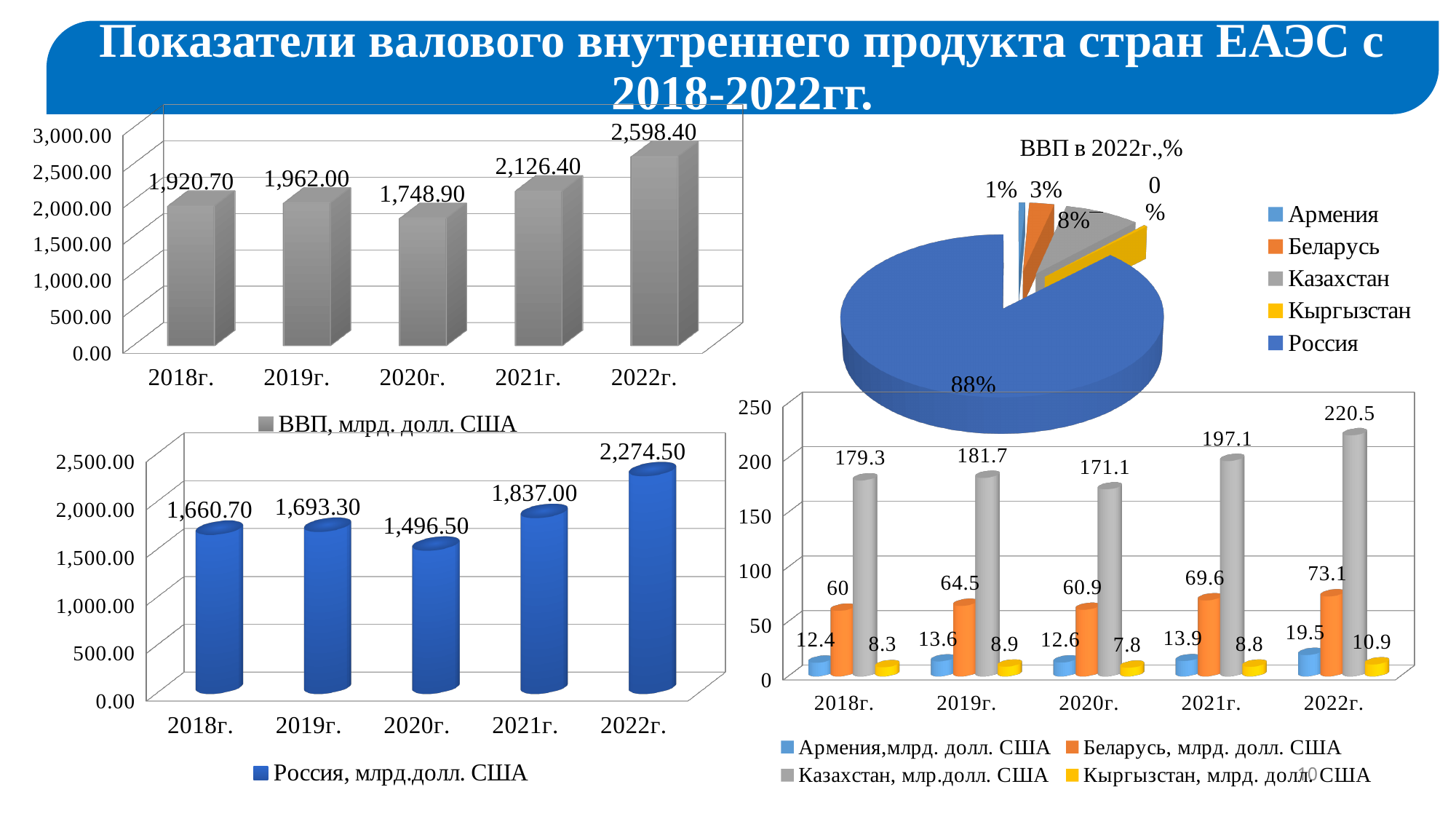
What type of chart is the top-right chart titled ВВП в 2022г.,%? Pie chart In the bottom-right chart, what is the value for Казахстан in 2021г.? 197.1 In the pie chart titled ВВП в 2022г.,%, how many entries does the legend list? 5 In the bottom-right chart, what is the value for Беларусь in 2019г.? 64.5 In the bottom-right chart, which is larger: Армения in 2022г. or Кыргызстан in 2022г.? Армения in 2022г. In the pie chart titled ВВП в 2022г.,%, what share does Россия have? 88% In the top-left chart (ВВП, млрд. долл. США), which year has the lowest value? 2020г. In the top-left chart (ВВП, млрд. долл. США), what is the difference between the 2022г. and 2021г. values? 472.00 In the bottom-left chart (Россия, млрд.долл. США), which year has the highest value? 2022г. In the bottom-left chart (Россия, млрд.долл. США), how many years are shown on the x axis? 5 In the top-left chart (ВВП, млрд. долл. США), what is the value for 2022г.? 2,598.40 In the bottom-left chart (Россия, млрд.долл. США), what is the value for 2020г.? 1,496.50